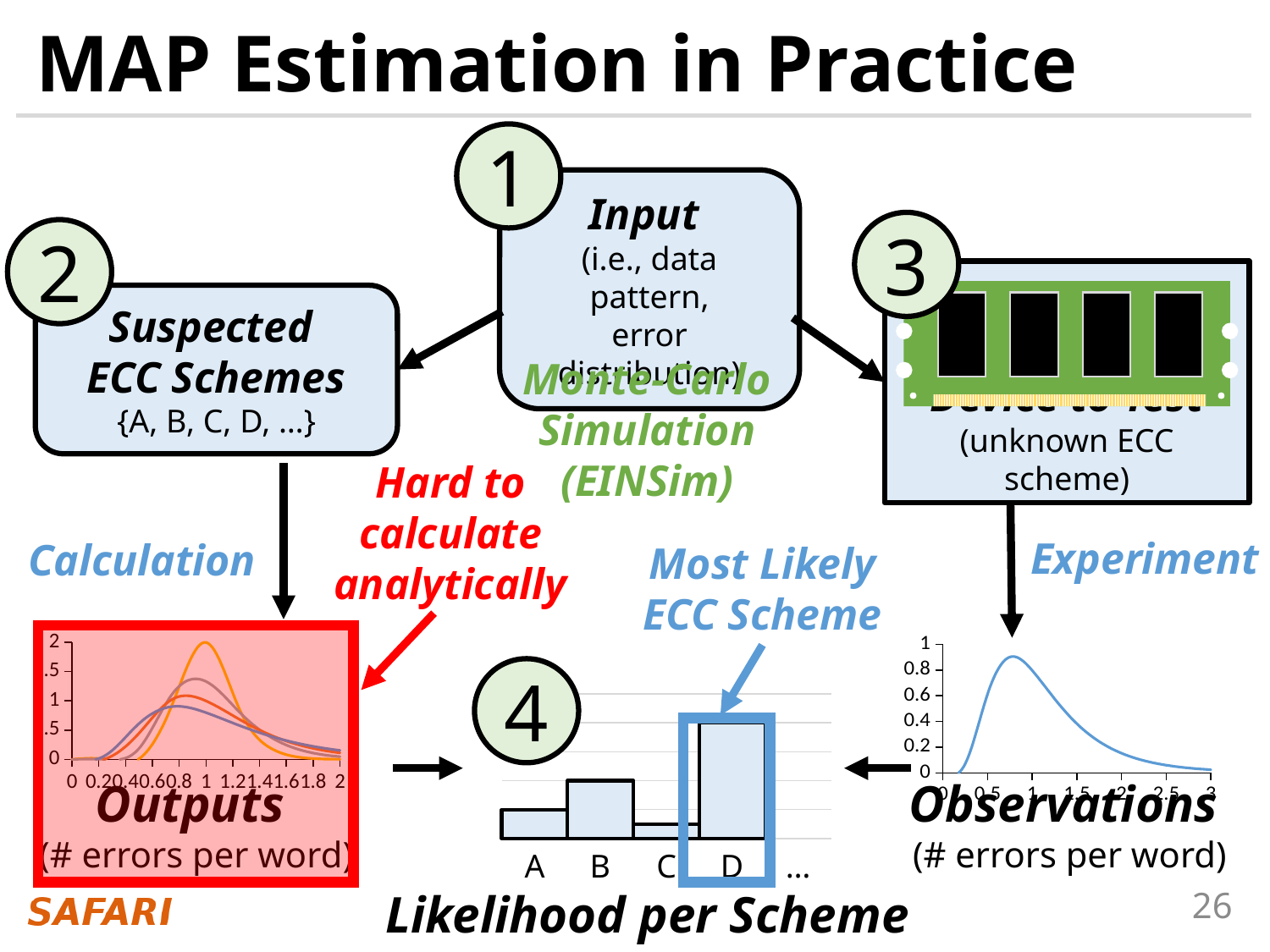
What kind of chart is the Likelihood per Scheme chart? bar chart In the Observations chart, what is the maximum value shown on the y axis? 1 In the Likelihood per Scheme chart, which scheme is highlighted with a blue box as the most likely ECC scheme? D In the Likelihood per Scheme chart, which has the larger bar, B or D? D In the Outputs chart, how many curves are plotted? 4 In the Observations chart, is the peak value of the curve greater or less than 0.8? greater In the Likelihood per Scheme chart, which scheme has the lowest likelihood? C In the Likelihood per Scheme chart, which has the larger bar, A or B? B How many labeled scheme categories (excluding the ellipsis) are shown on the x axis of the Likelihood per Scheme chart? 4 In the Likelihood per Scheme chart, which scheme has the highest likelihood? D What kind of chart is the Observations chart on the bottom right? line chart What kind of chart is the Outputs chart on the bottom left? line chart